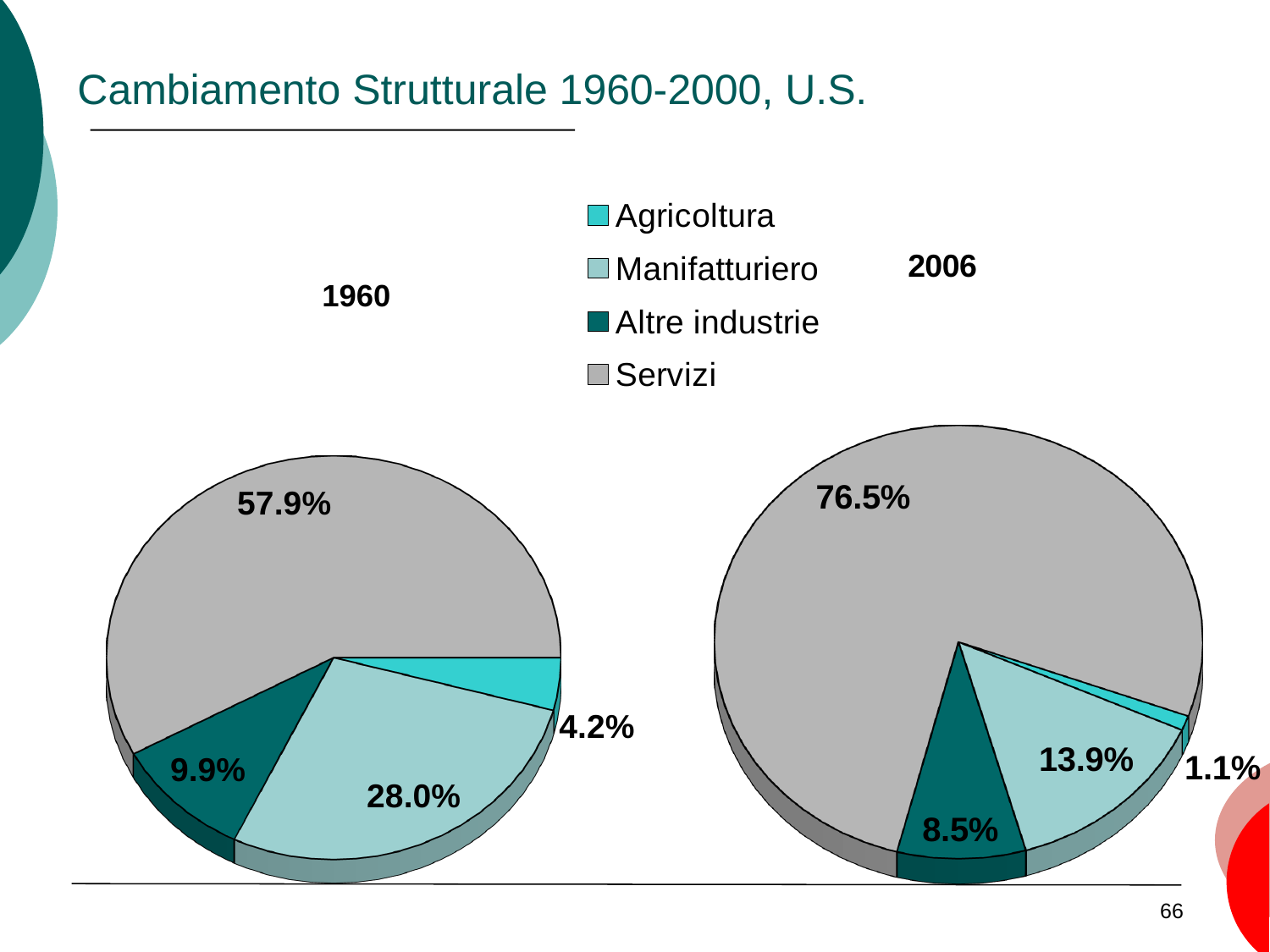
In the 1960 pie chart, which category has the smallest slice? Agricoltura In the 2006 pie chart, what share does Altre industrie have? 8.5% How many categories does the legend list? 4 In the 2006 pie chart, which category has the largest slice? Servizi What kind of chart is used on this slide? Pie chart In the 1960 pie chart, what share does Agricoltura have? 4.2% What is the difference between the Servizi share in 2006 and the Servizi share in 1960? 18.6% How many slices does the 2006 pie chart have? 4 In the 1960 pie chart, what share does Servizi have? 57.9% In the 2006 pie chart, what share does Manifatturiero have? 13.9% Which is larger: the Manifatturiero share in 1960 or the Manifatturiero share in 2006? 1960 In the 1960 pie chart, what is the difference between the Manifatturiero and Altre industrie shares? 18.1%